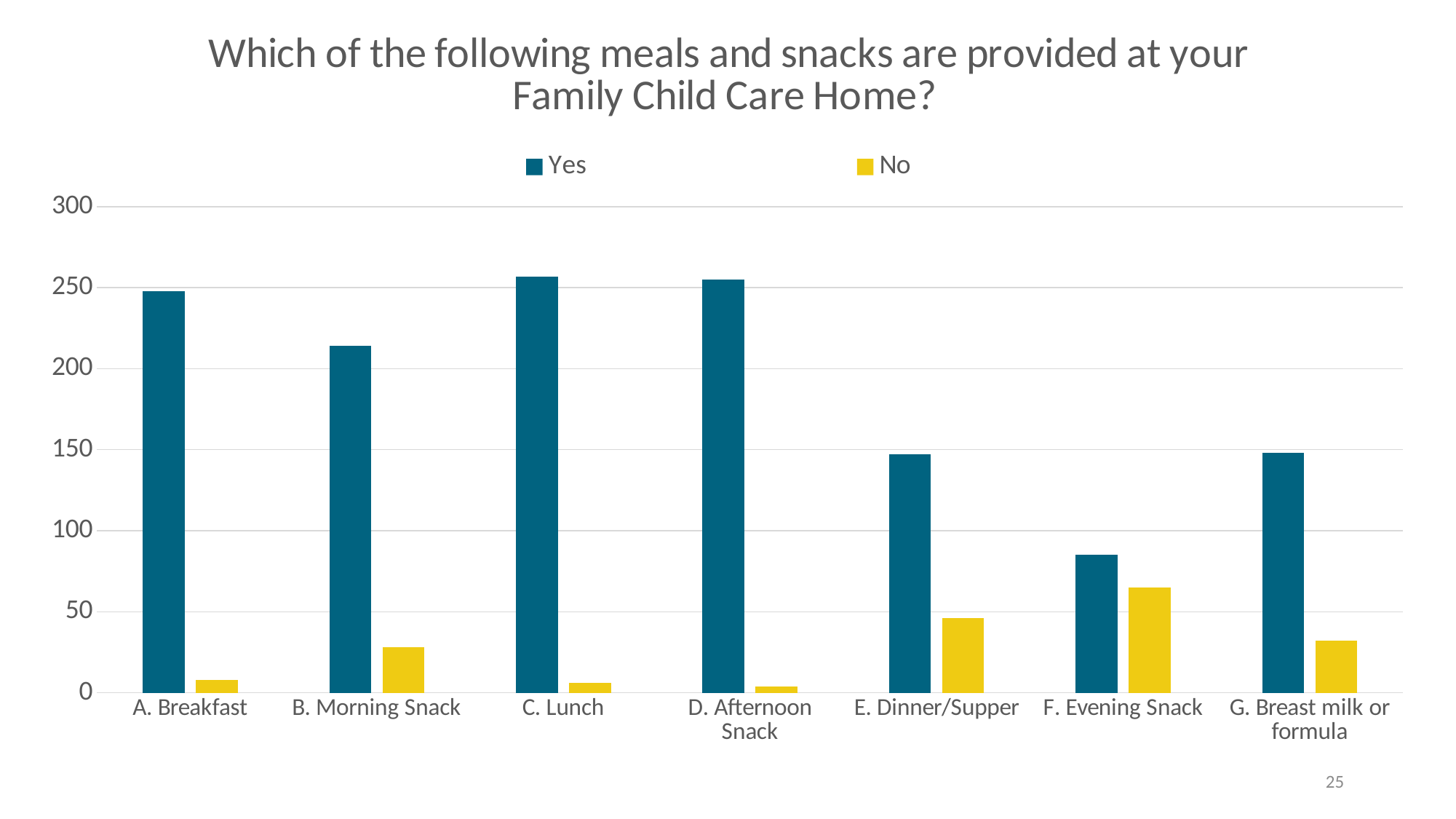
Which category has the lowest Yes value? F. Evening Snack Is the No value for F. Evening Snack greater or less than 50? greater Which is larger, the Yes value for A. Breakfast or the Yes value for B. Morning Snack? A. Breakfast What kind of chart is shown on the slide? bar chart How many series does the legend list? 2 Is the Yes value for F. Evening Snack greater or less than 100? less How many meal and snack categories are shown on the x axis? 7 Is the Yes value for A. Breakfast greater or less than 200? greater Which category has the highest No value? F. Evening Snack Which is larger, the No value for E. Dinner/Supper or the No value for C. Lunch? E. Dinner/Supper What colour are the bars for the No series? yellow